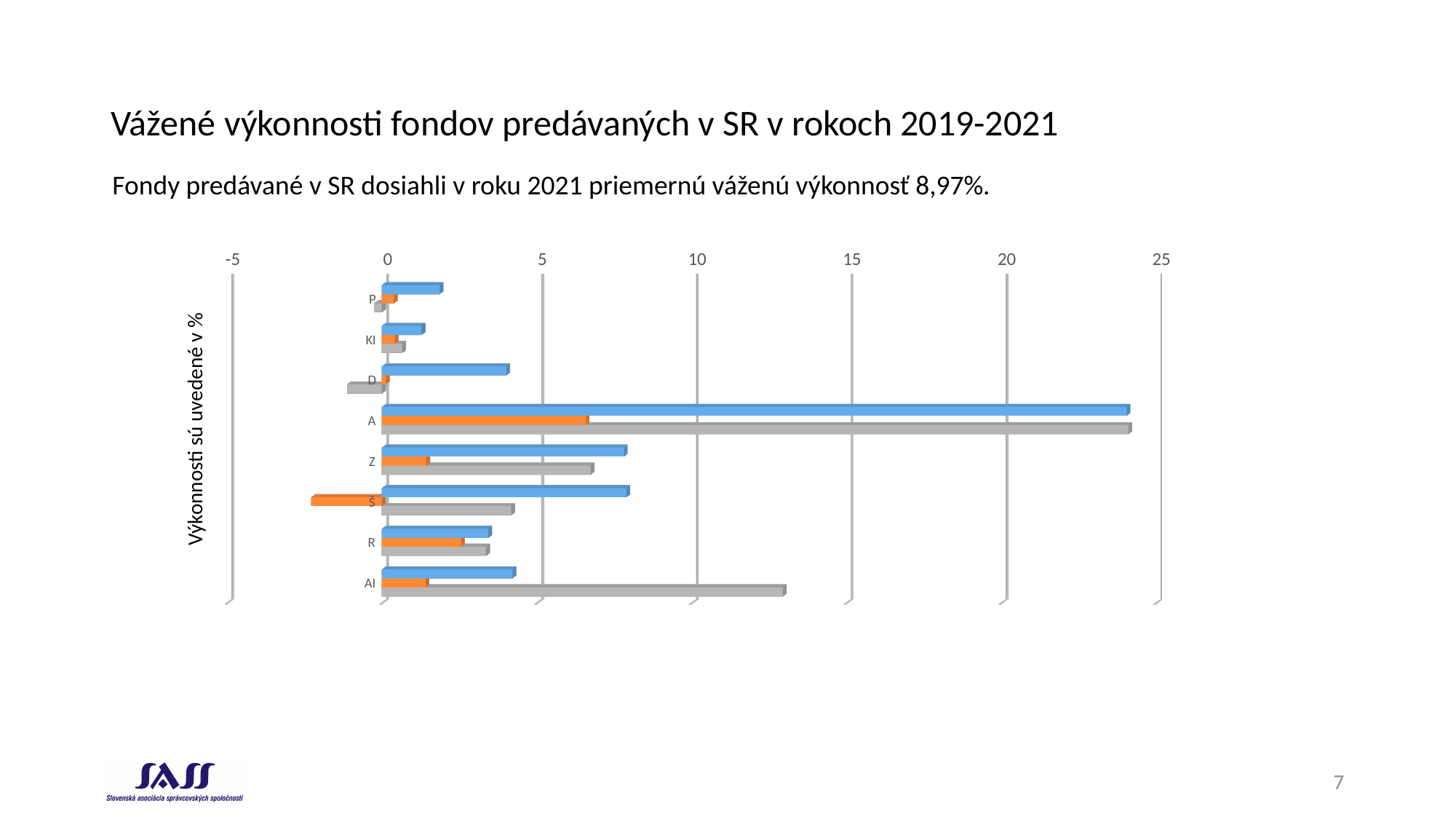
How many categories are listed on the vertical axis of the chart? 8 Which is larger, the blue bar for A or the blue bar for Z? the blue bar for A Is the value of the blue bar for A greater or less than 20? greater Is the value of the orange bar for Š greater or less than 0? less Which category has the longest gray bar? A Is the value of the gray bar for D greater or less than 0? less Which is larger, the gray bar for AI or the gray bar for Z? the gray bar for AI What kind of chart is shown on the slide? bar chart What is the title of the vertical axis of the chart? Výkonnosti sú uvedené v % Which category has the longest blue bar? A